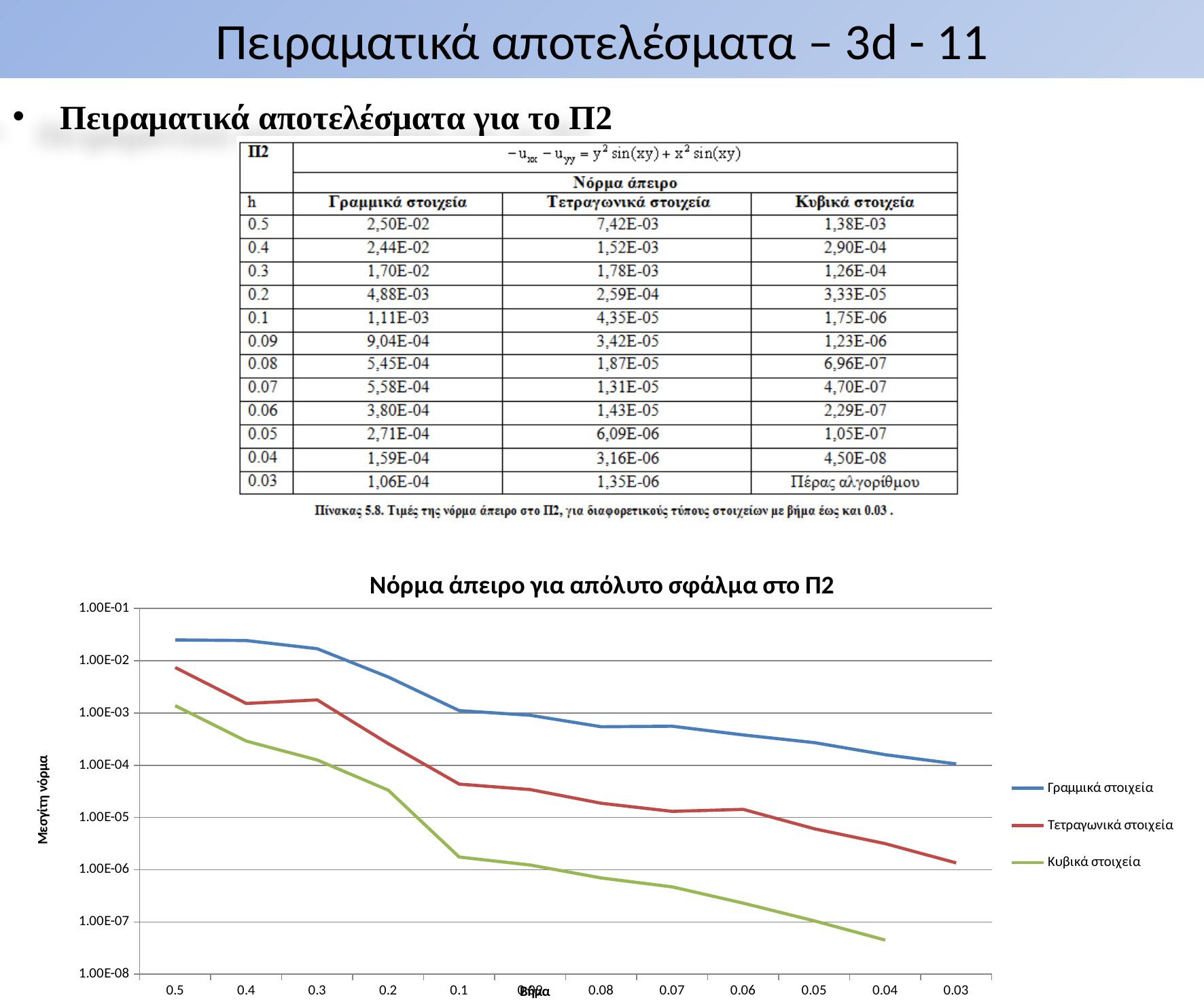
Is the value of the Γραμμικά στοιχεία series at h = 0.5 greater or less than 1.00E-02? greater Does the Γραμμικά στοιχεία series rise or fall as h decreases from 0.5 to 0.03 along the x axis? Fall At h = 0.5, which is larger: the Γραμμικά στοιχεία value or the Κυβικά στοιχεία value? Γραμμικά στοιχεία Which series has the lowest value at h = 0.06? Κυβικά στοιχεία Is the value of the Τετραγωνικά στοιχεία series at h = 0.1 greater or less than 1.00E-04? less What is the title of the chart? Νόρμα άπειρο για απόλυτο σφάλμα στο Π2 Is the value of the Γραμμικά στοιχεία series at h = 0.2 greater or less than 1.00E-02? less How many step values (h) are shown along the x axis of the chart? 12 How many series does the legend of the chart list? 3 What kind of chart is shown under the title 'Νόρμα άπειρο για απόλυτο σφάλμα στο Π2'? Line chart Which series has the highest value at h = 0.3? Γραμμικά στοιχεία